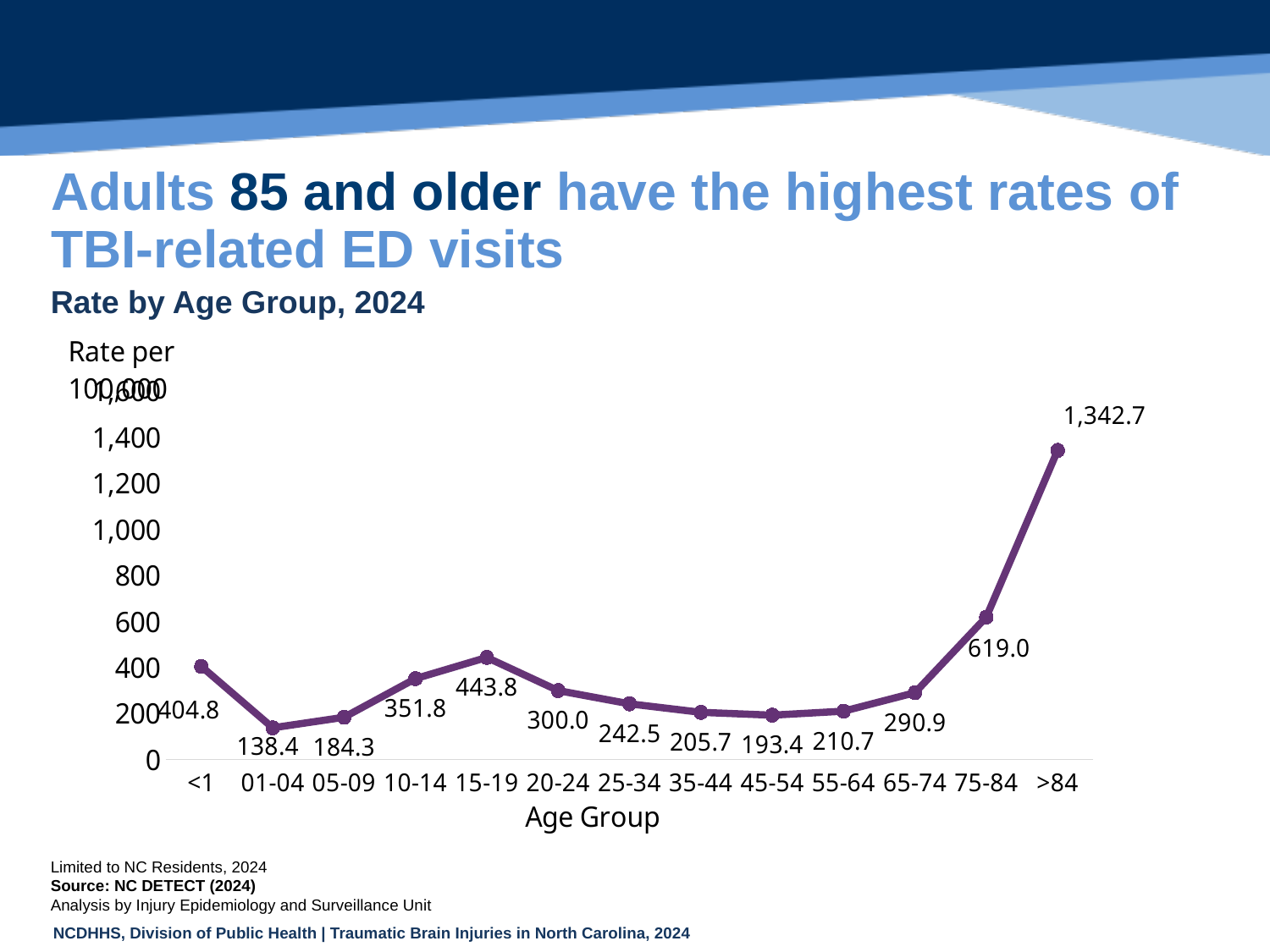
What is the rate per 100,000 for the >84 age group? 1,342.7 What is the label of the x axis of the chart? Age Group What is the difference between the rates for the >84 and 75-84 age groups? 723.7 Which age group has the highest rate of TBI-related ED visits? >84 Which age group has a higher rate, 20-24 or 65-74? 20-24 What is the rate per 100,000 for the <1 age group? 404.8 Which age group has the lowest rate of TBI-related ED visits? 01-04 What is the rate per 100,000 for the 15-19 age group? 443.8 How many age groups are plotted on the chart? 13 What kind of chart is shown on the slide? Line chart What is the difference between the rates for the 15-19 and 10-14 age groups? 92.0 Is the rate for the 75-84 age group greater or less than 600? greater